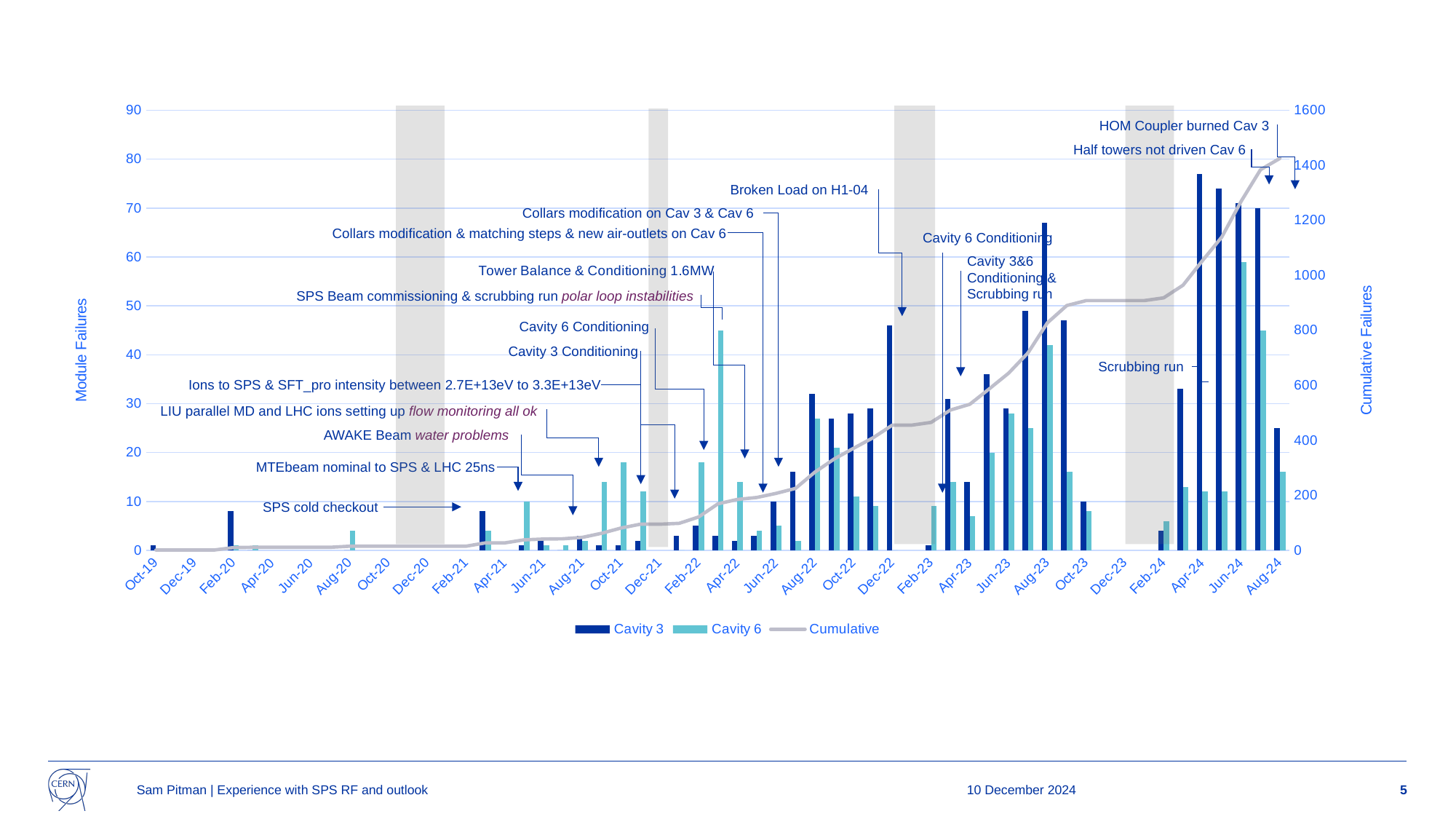
What is the title of the right-hand vertical axis? Cumulative Failures Is the Cavity 3 value for Feb-20 greater or less than 10? less How many series does the legend list? 3 Is the Cavity 3 value for Dec-22 greater or less than 40? greater For Apr-24, which is larger, the Cavity 3 value or the Cavity 6 value? Cavity 3 Is the Cumulative value at Aug-24 greater or less than 1200? greater What are the three series named in the legend? Cavity 3, Cavity 6, Cumulative Which series has the tallest bar on the chart, Cavity 3 or Cavity 6? Cavity 3 What kind of chart is shown on the slide? A bar chart combined with a line Does the Cumulative line rise or fall from Oct-19 to Aug-24? Rises